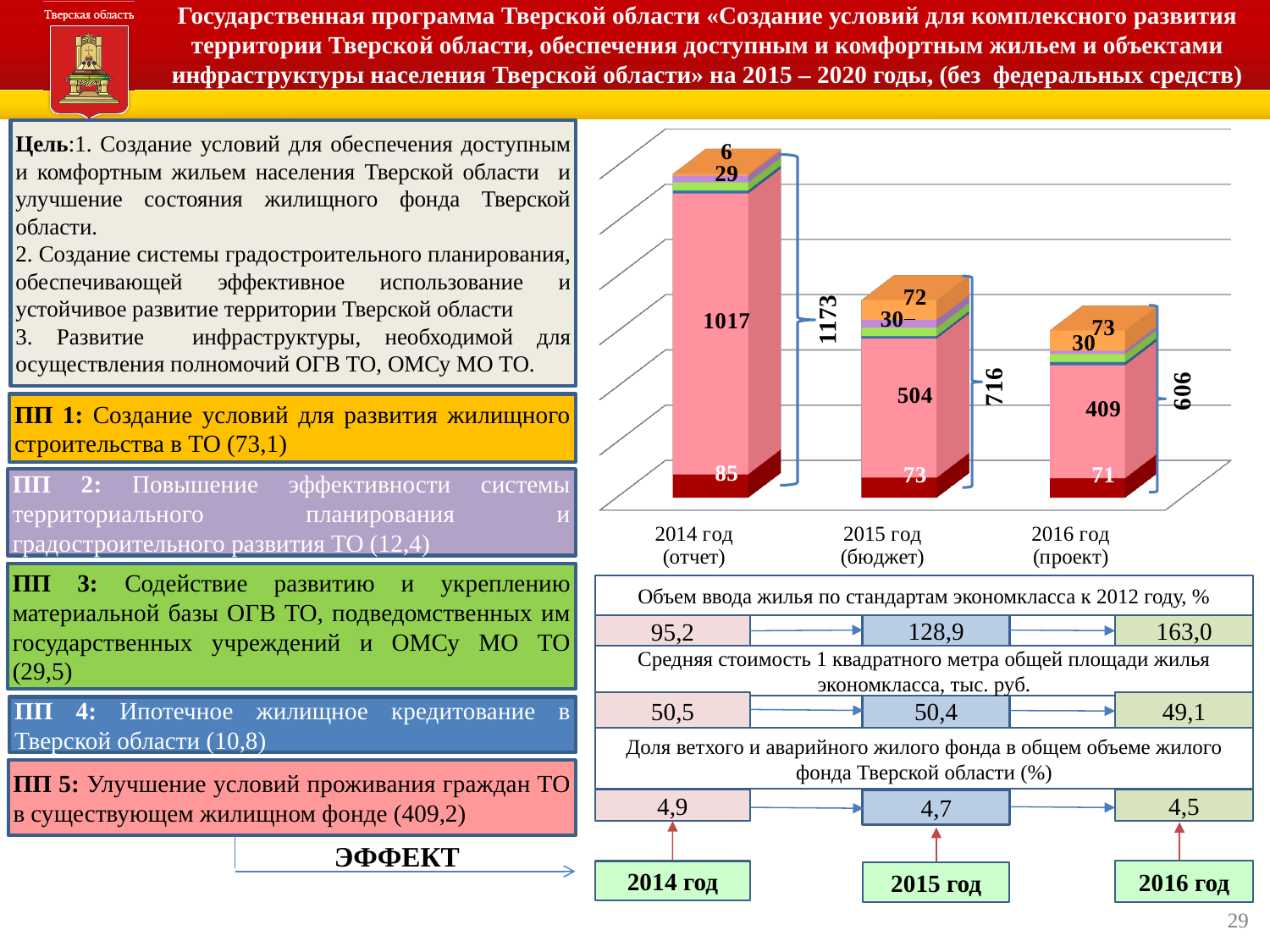
What type of chart is shown on the right side of the slide? bar chart What is the value of the largest (pink) segment in the 2015 год bar? 504 What is the total value shown for the 2014 год (отчет) bar? 1173 Do the bar totals rise or fall from 2014 to 2016? fall Which year has the lowest total on the bar chart? 2016 год (проект) How many categories (years) are shown on the bar chart? 3 Is the total for 2015 год larger or smaller than the total for 2016 год? larger What is the total value shown for the 2015 год (бюджет) bar? 716 What is the total value shown for the 2016 год (проект) bar? 606 Which year has the highest total on the bar chart? 2014 год (отчет) What is the value of the bottom (dark red) segment in the 2014 год bar? 85 What is the difference between the totals for 2014 год and 2015 год? 457